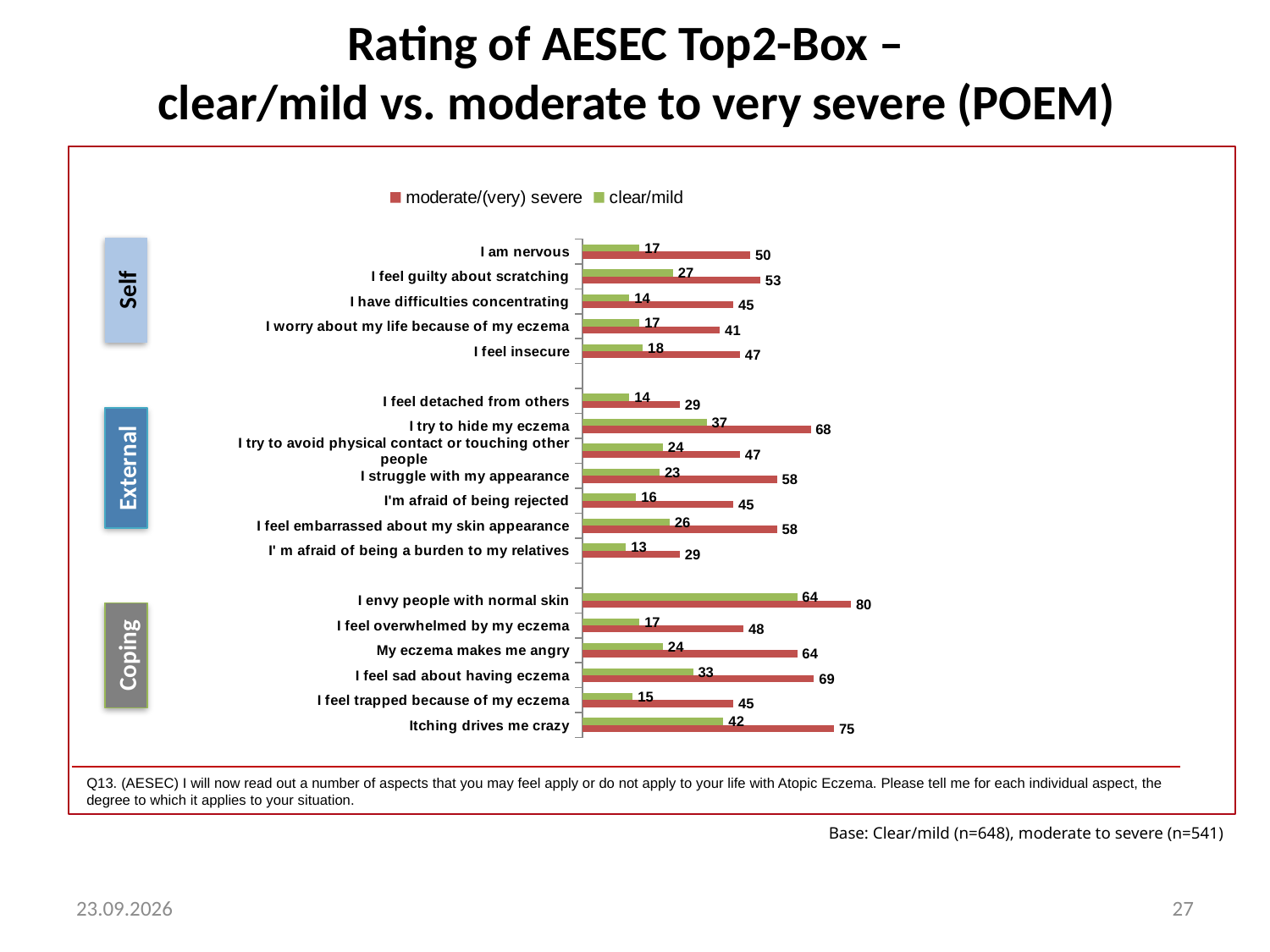
How many statements are plotted in the chart? 18 Which statement has the lowest clear/mild value? I' m afraid of being a burden to my relatives What is the moderate/(very) severe value for "Itching drives me crazy"? 75 What is the difference between the moderate/(very) severe and clear/mild values for "My eczema makes me angry"? 40 What kind of chart is shown on the slide? Bar chart Which is larger: the clear/mild value for "I feel sad about having eczema" or the clear/mild value for "I feel guilty about scratching"? I feel sad about having eczema What is the clear/mild value for "I try to hide my eczema"? 37 What is the moderate/(very) severe value for "I am nervous"? 50 What is the clear/mild value for "I envy people with normal skin"? 64 Which statement has the highest moderate/(very) severe value? I envy people with normal skin Which colour represents the clear/mild series in the chart? Green How many series does the legend list? 2